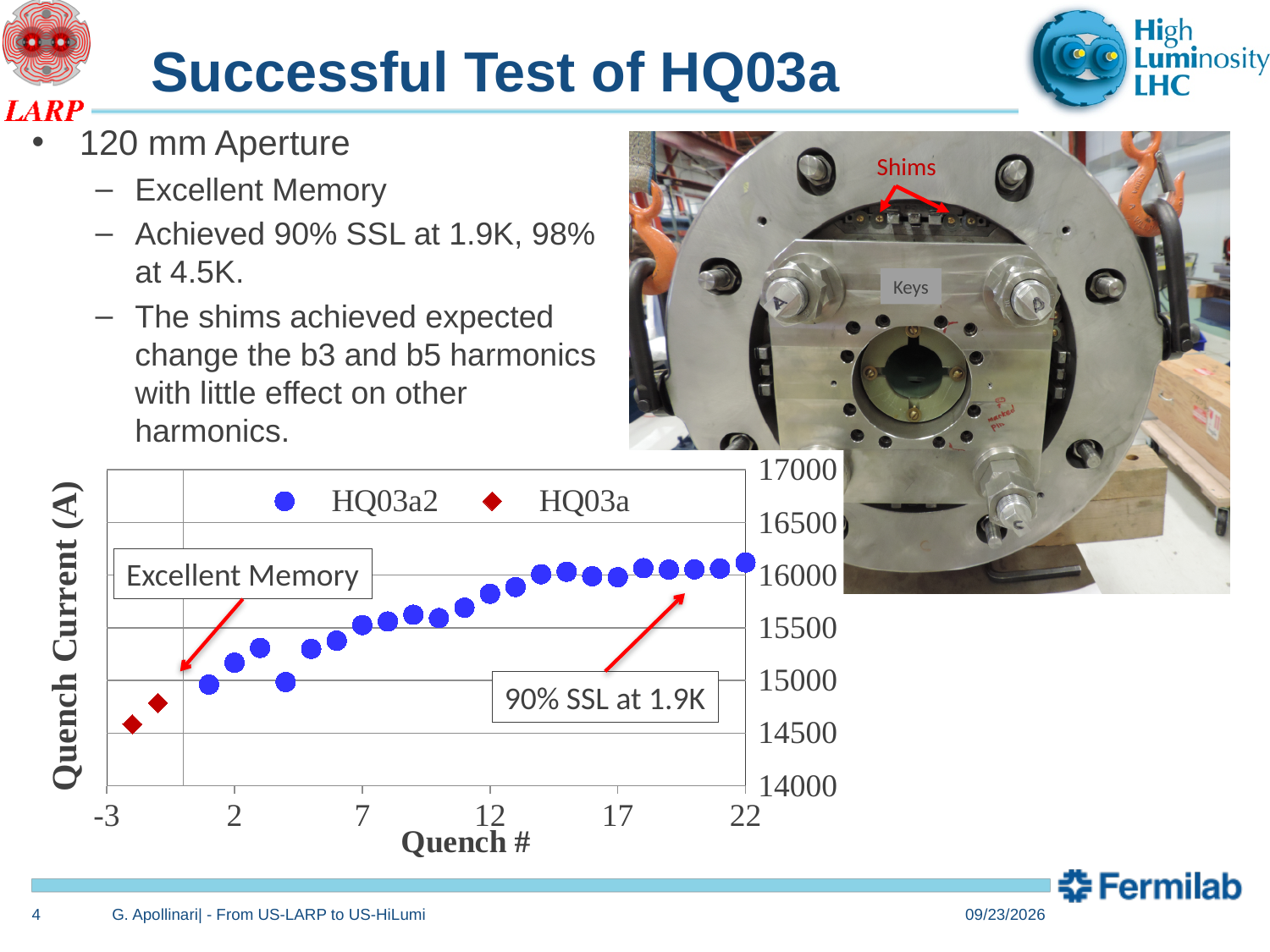
What is the label of the chart's y axis? Quench Current (A) Is the highest HQ03a2 quench current greater or less than 16500 A? less Are the HQ03a2 quench currents at quench numbers 17 and above greater or less than 15500 A? greater What are the two series named in the chart legend? HQ03a2 and HQ03a Which series reaches the higher quench current, HQ03a2 or HQ03a? HQ03a2 How many series does the chart legend list? 2 Do the HQ03a2 quench current values generally rise or fall as the quench number increases? rise What kind of chart is shown on the slide? scatter chart Are the HQ03a (red diamond) quench current values greater or less than 15000 A? less How many HQ03a (red diamond) data points are plotted on the chart? 2 Which series has the lowest plotted quench current on the chart? HQ03a